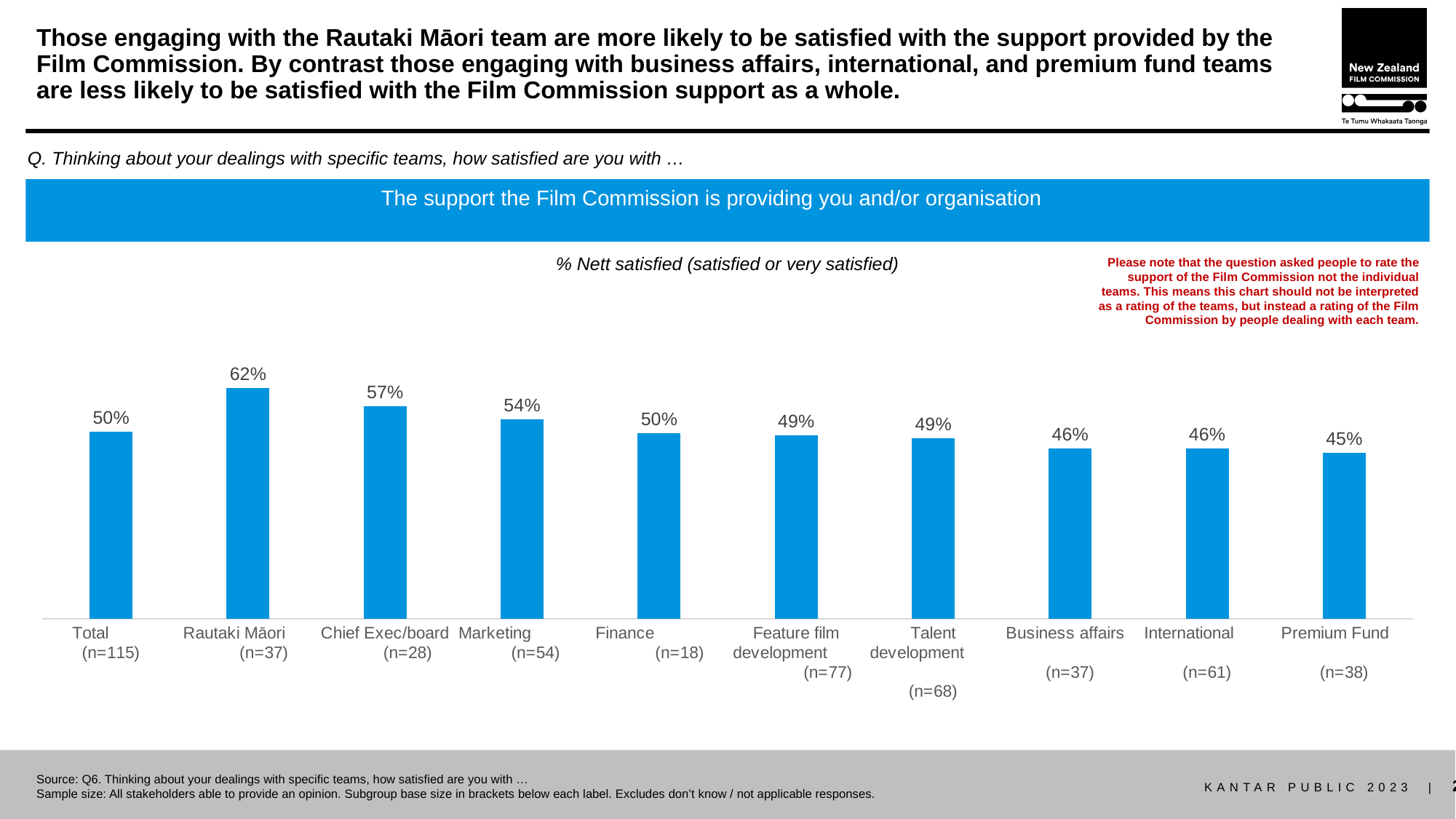
What is the % nett satisfied value for Marketing? 54% What is the % nett satisfied value for Premium Fund? 45% Which category has the lowest % nett satisfied? Premium Fund What type of chart is shown on the slide? Bar chart Which has a higher % nett satisfied, Marketing or International? Marketing What is the % nett satisfied value for Rautaki Māori? 62% What is the difference in % nett satisfied between Chief Exec/board and Business affairs? 11 percentage points What is the % nett satisfied value for Total? 50% What is the sample size (n) shown for Feature film development? n=77 Which category has the highest % nett satisfied? Rautaki Māori What is the difference in % nett satisfied between Rautaki Māori and Premium Fund? 17 percentage points How many categories are shown on the chart? 10